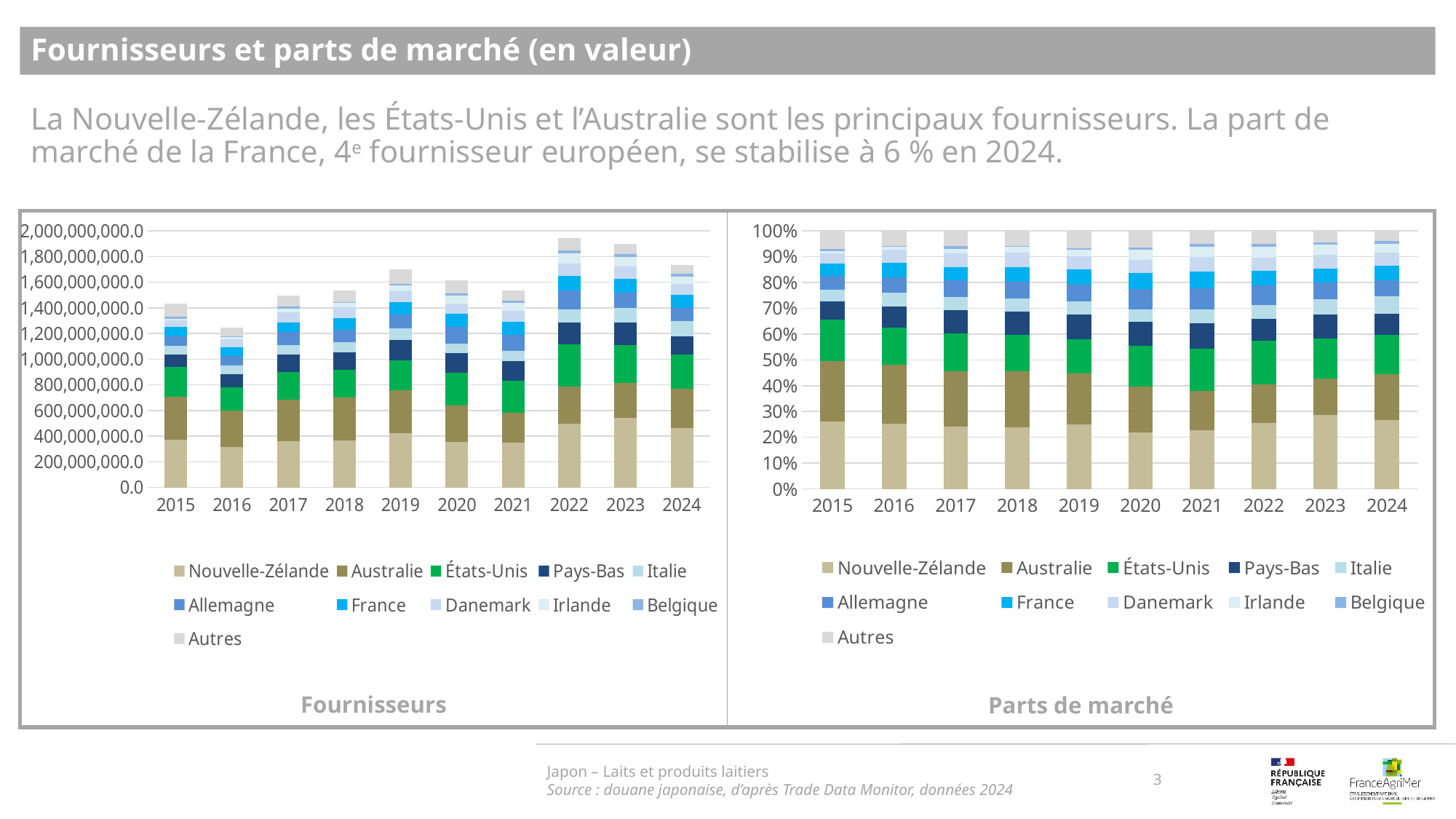
What is the title of the chart on the right side of the slide? Parts de marché In the 'Fournisseurs' chart, is the total for 2016 greater or less than 1,400,000,000.0? less In the 'Fournisseurs' chart, which year has the larger total bar, 2016 or 2017? 2017 In the 'Fournisseurs' chart, which year has the highest total bar? 2022 In the 'Fournisseurs' chart, which year has the lowest total bar? 2016 In the 'Fournisseurs' chart, is the total for 2022 greater or less than 1,800,000,000.0? greater In the 'Fournisseurs' chart, is the total for 2024 greater or less than 1,800,000,000.0? less How many series does the legend of the 'Fournisseurs' chart list? 11 What kind of chart is the 'Fournisseurs' chart on the left? stacked bar chart In the 'Fournisseurs' chart, do the total bars rise or fall from 2016 to 2019? rise How many years are shown on the x axis of the 'Parts de marché' chart? 10